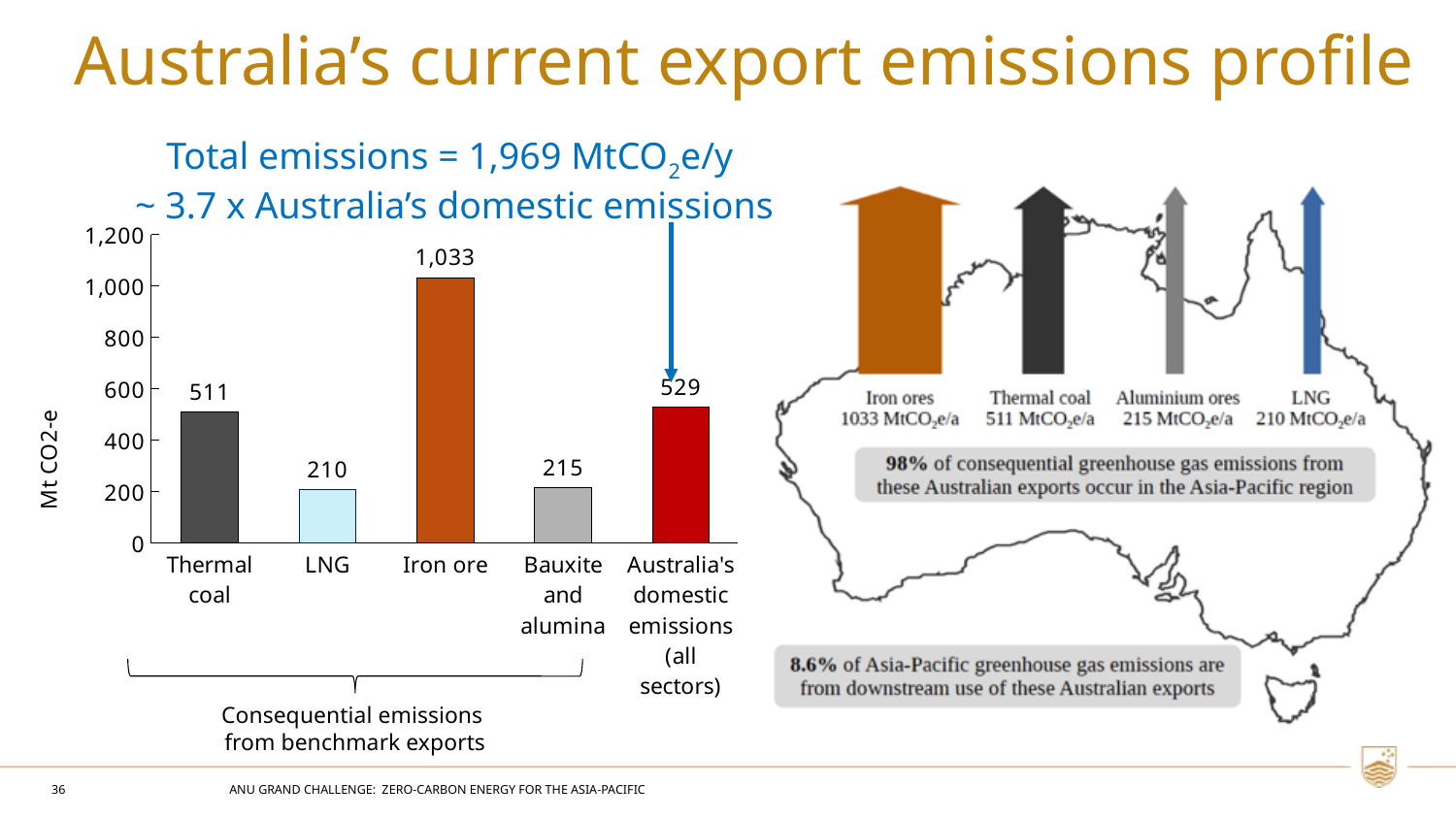
Which category has the lowest value in the bar chart? LNG What is the value for LNG in the bar chart? 210 How many categories are shown in the bar chart? 5 What is the difference between the Iron ore value and the Thermal coal value in the bar chart? 522 Which is larger in the bar chart, Thermal coal or Australia's domestic emissions? Australia's domestic emissions What kind of chart is shown on the slide? Bar chart What is the value for Thermal coal in the bar chart? 511 What is the value shown for Australia's domestic emissions (all sectors) in the bar chart? 529 What is the label of the vertical axis of the bar chart? Mt CO2-e Which category has the highest value in the bar chart? Iron ore What is the value for Iron ore in the bar chart? 1,033 What is the value for Bauxite and alumina in the bar chart? 215